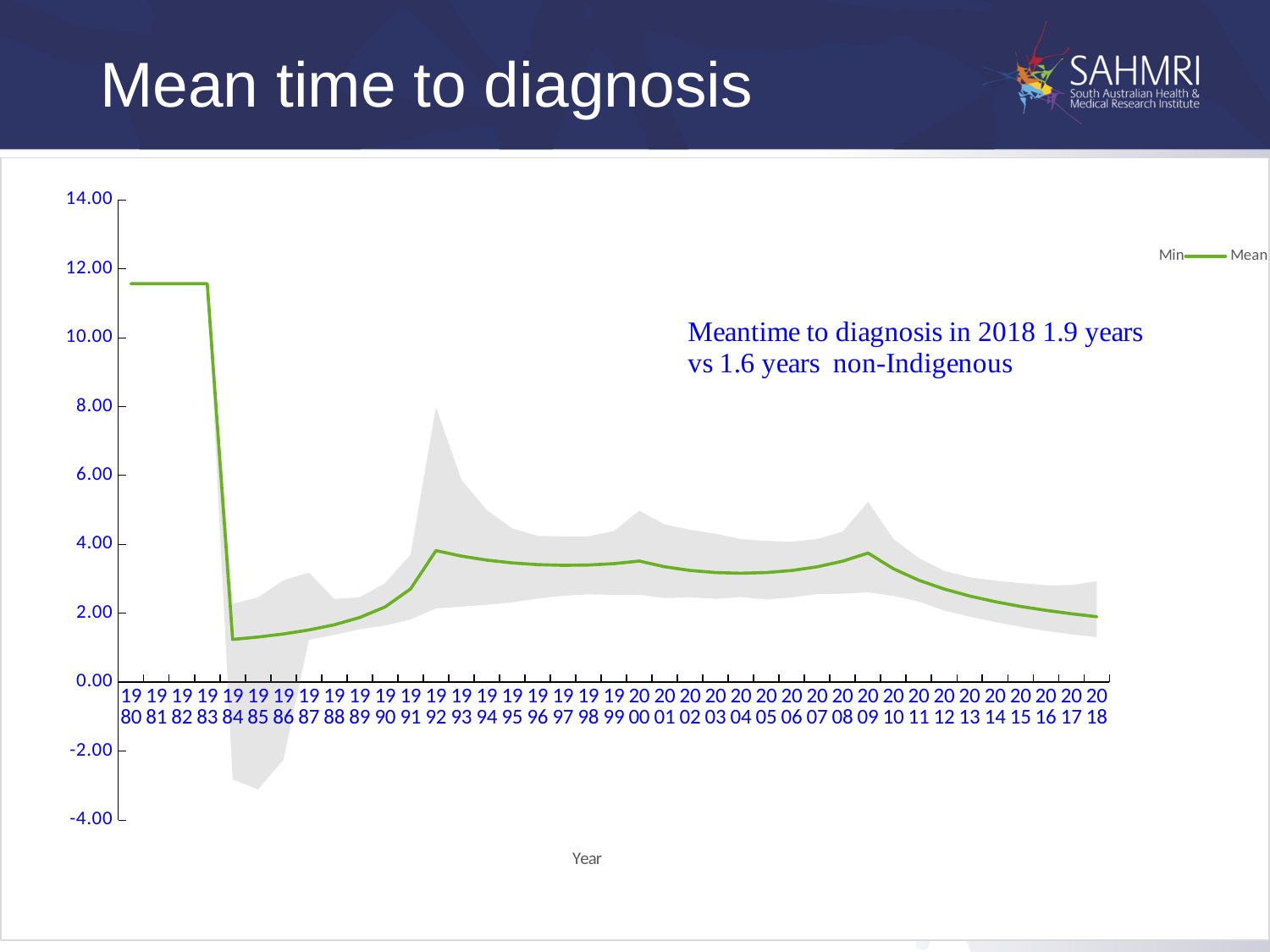
According to the slide, what was the mean time to diagnosis in 2018? 1.9 years How many series does the chart legend list? 2 What is the label of the x axis? Year What is the title of the chart on the slide? Mean time to diagnosis Is the Mean value for 1992 greater or less than 2.00? greater Does the Mean line rise or fall from 2009 to 2018? fall Which has the larger Mean value, 1980 or 2018? 1980 How many years are plotted along the x axis? 39 Is the Mean value for 1980 greater or less than 10.00? greater Is the Mean value for 1984 greater or less than 2.00? less What type of chart is shown on the slide? line chart